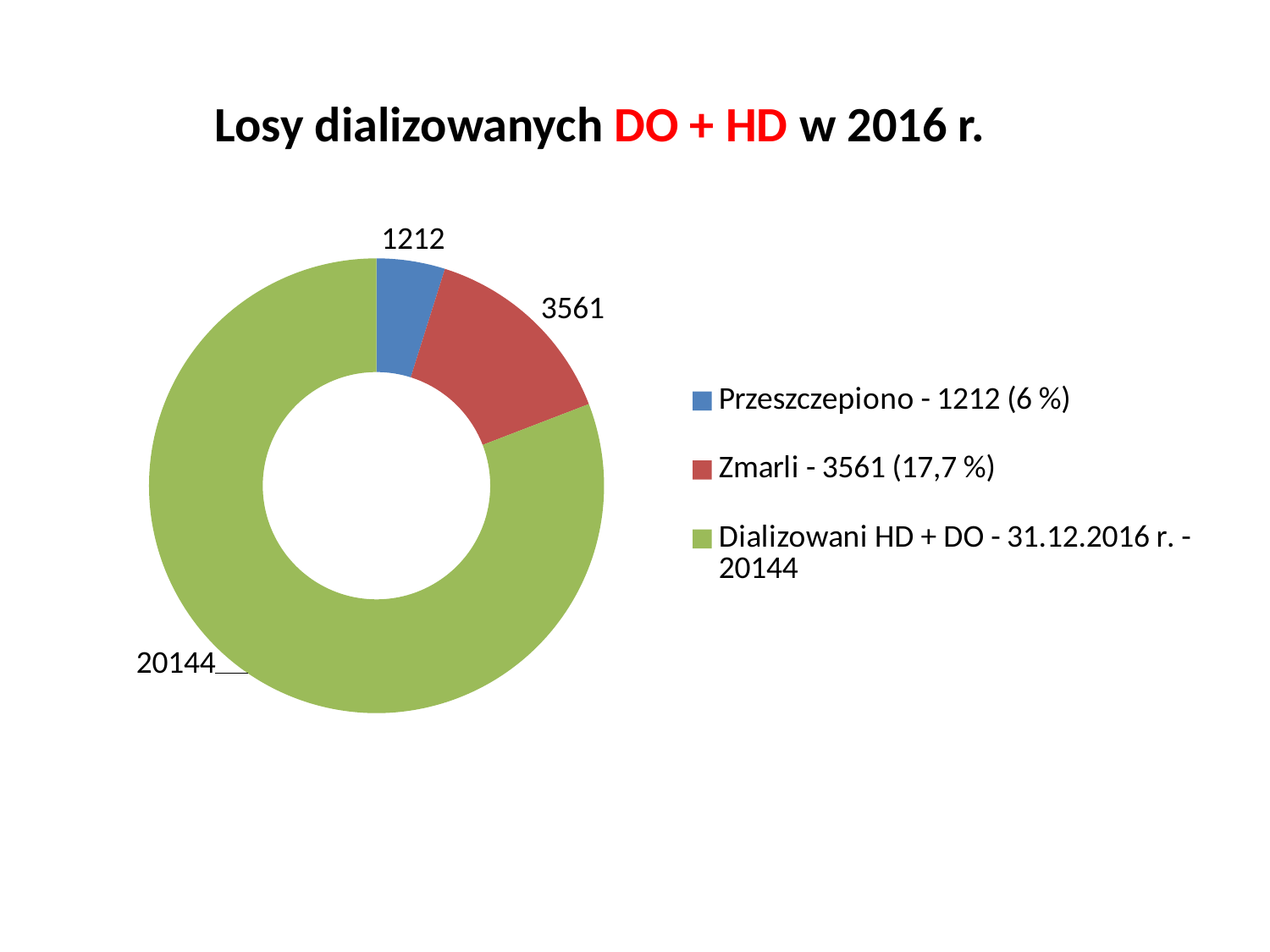
Which category has the largest slice? Dializowani HD + DO - 31.12.2016 r. What is the value for Dializowani HD + DO - 31.12.2016 r.? 20144 What share of the total does Zmarli represent, as shown in the legend? 17,7 % What share of the total does Przeszczepiono represent, as shown in the legend? 6 % What is the title of the chart? Losy dializowanych DO + HD w 2016 r. How many slices does the chart have? 3 What is the value for Przeszczepiono? 1212 Which is larger, the value for Zmarli or the value for Przeszczepiono? Zmarli What kind of chart is shown on the slide? Doughnut (pie) chart What is the value for Zmarli? 3561 Which category has the smallest slice? Przeszczepiono What is the difference between the values for Zmarli and Przeszczepiono? 2349